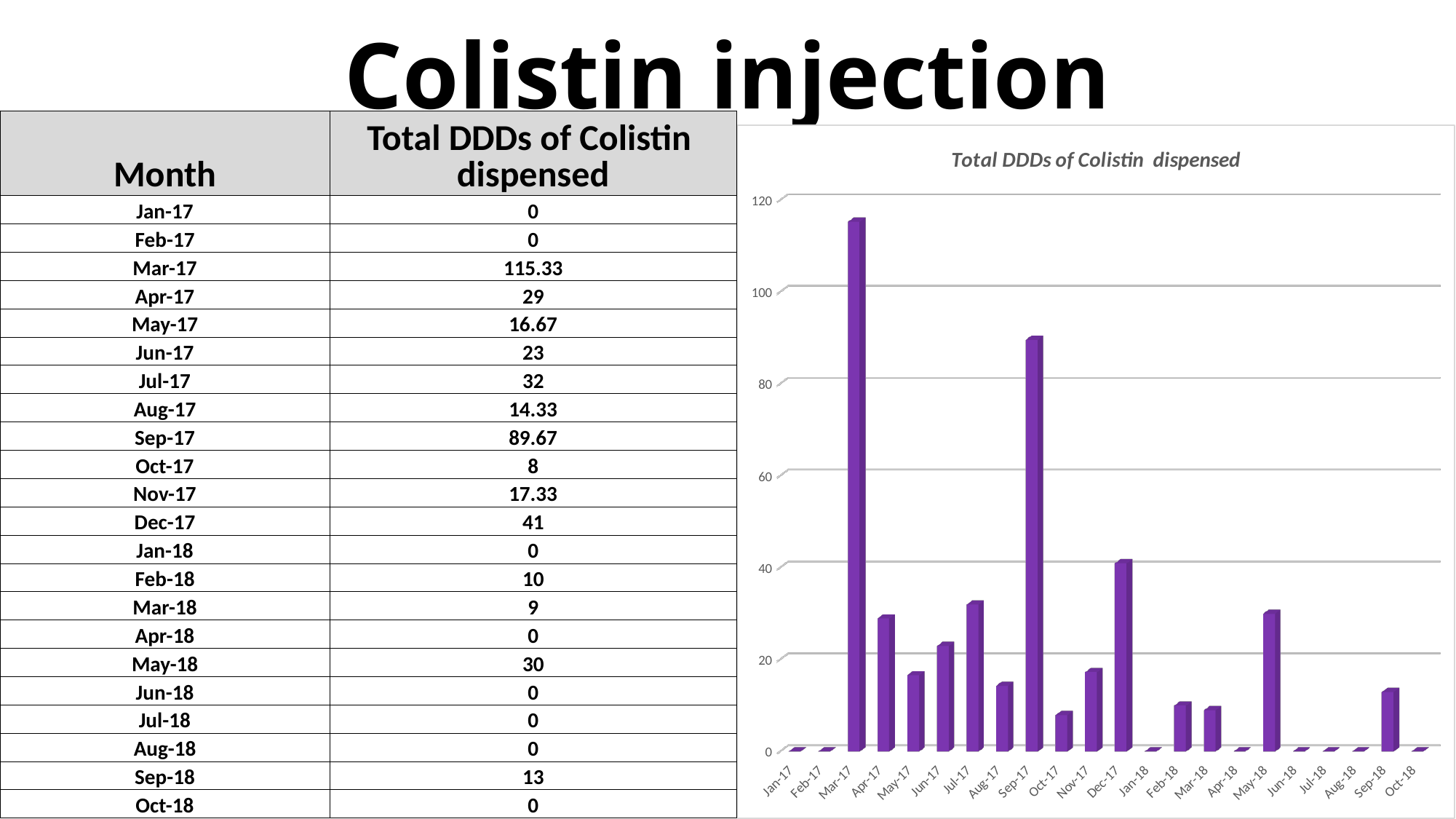
What is the difference between the values for Dec-17 and May-18? 11 What type of chart is shown on the slide? bar chart What is the total DDDs of Colistin dispensed in Mar-17? 115.33 What is the difference between the values for Mar-17 and Sep-17? 25.66 What is the total DDDs of Colistin dispensed in Sep-17? 89.67 What is the title of the chart? Total DDDs of Colistin dispensed What is the total DDDs of Colistin dispensed in Dec-17? 41 Is the value for May-18 greater or less than 40? less Which month has the highest total DDDs of Colistin dispensed? Mar-17 Is the value for Sep-17 greater or less than 80? greater Which is larger, the value for Jul-17 or the value for Apr-17? Jul-17 How many months are plotted along the x axis of the chart? 22